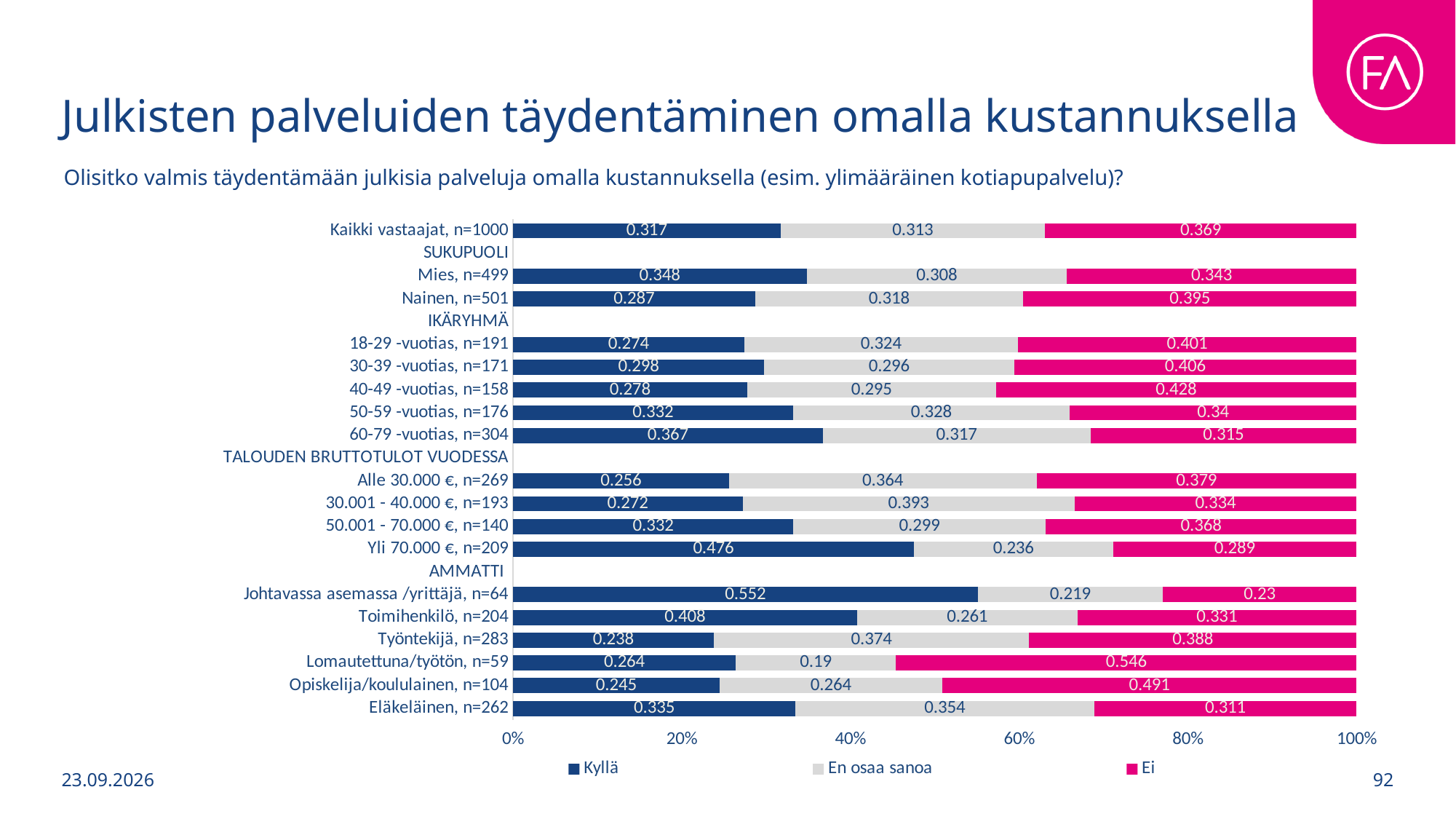
What is the Ei value for Lomautettuna/työtön, n=59? 0.546 Which has the larger Ei value: 18-29 -vuotias, n=191 or 60-79 -vuotias, n=304? 18-29 -vuotias, n=191 What is the Kyllä value for Kaikki vastaajat, n=1000? 0.317 What is the total of the stacked bar for Nainen, n=501? 1 Which category has the highest Kyllä value? Johtavassa asemassa /yrittäjä, n=64 Which category has the lowest Kyllä value? Työntekijä, n=283 What is the difference between the Kyllä values for Mies, n=499 and Nainen, n=501? 0.061 What kind of chart is shown on the slide? Stacked bar chart How many series does the legend list? 3 What is the En osaa sanoa value for Yli 70.000 €, n=209? 0.236 What are the three legend entries of the chart? Kyllä, En osaa sanoa, Ei Which category has the highest Ei value? Lomautettuna/työtön, n=59